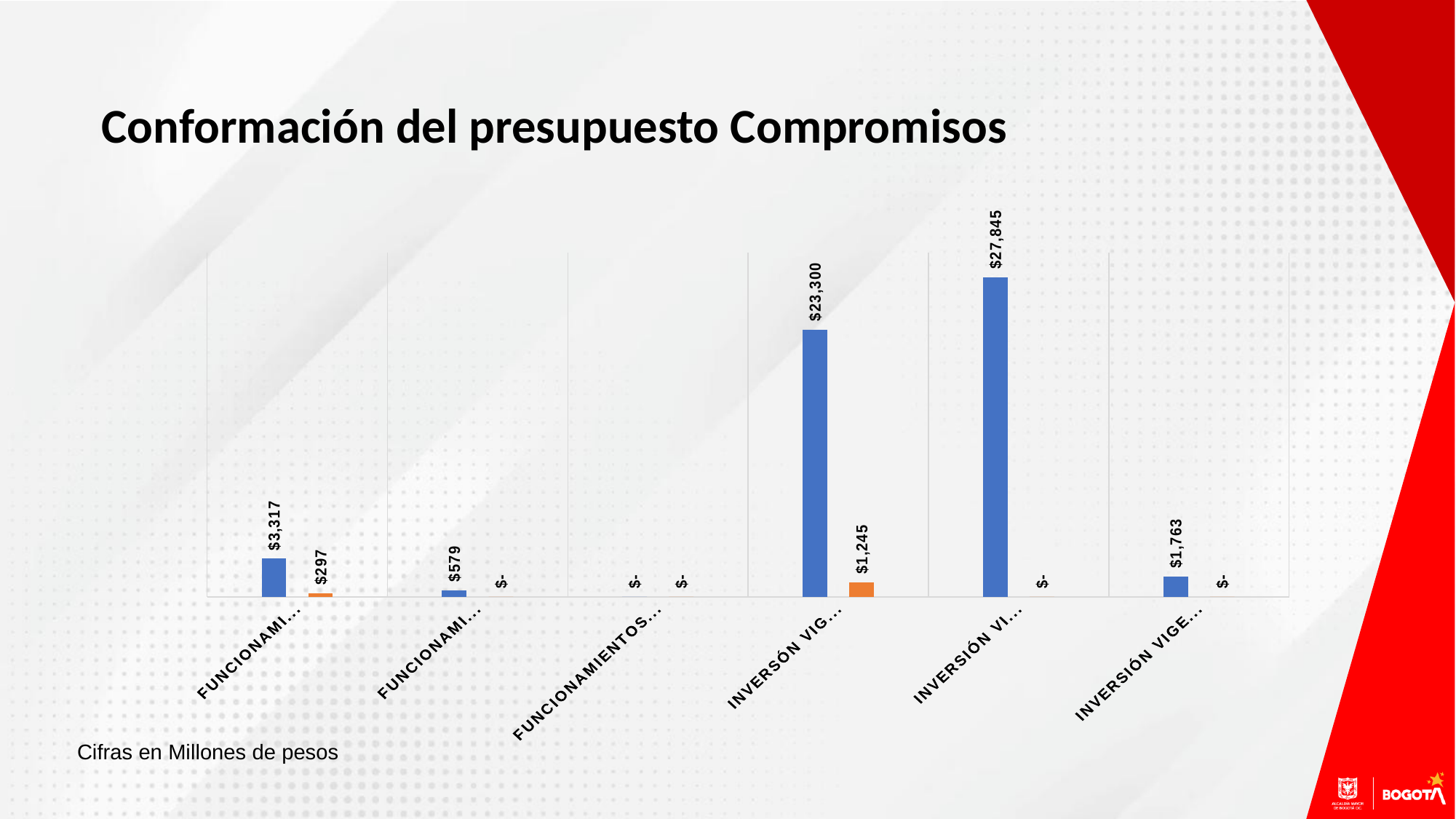
Which blue bar is larger: the second category from the left or the sixth category from the left? The sixth category What is the highest value shown by any blue bar in the chart? $27,845 For the first category from the left, how much larger is the blue bar ($3,317) than the orange bar ($297)? $3,020 What kind of chart is shown on the slide? Bar chart What is the title of the slide containing the chart? Conformación del presupuesto Compromisos What is the value of the blue bar for the first category from the left? $3,317 What is the difference between the blue bar of the fifth category ($27,845) and the blue bar of the fourth category ($23,300)? $4,545 What is the value of the blue bar for the sixth category from the left? $1,763 How many categories are shown along the x axis of the chart? 6 In what units are the chart's figures expressed, according to the note on the slide? Millones de pesos What is the value of the orange bar for the fourth category from the left? $1,245 What is the value of the orange bar for the first category from the left? $297